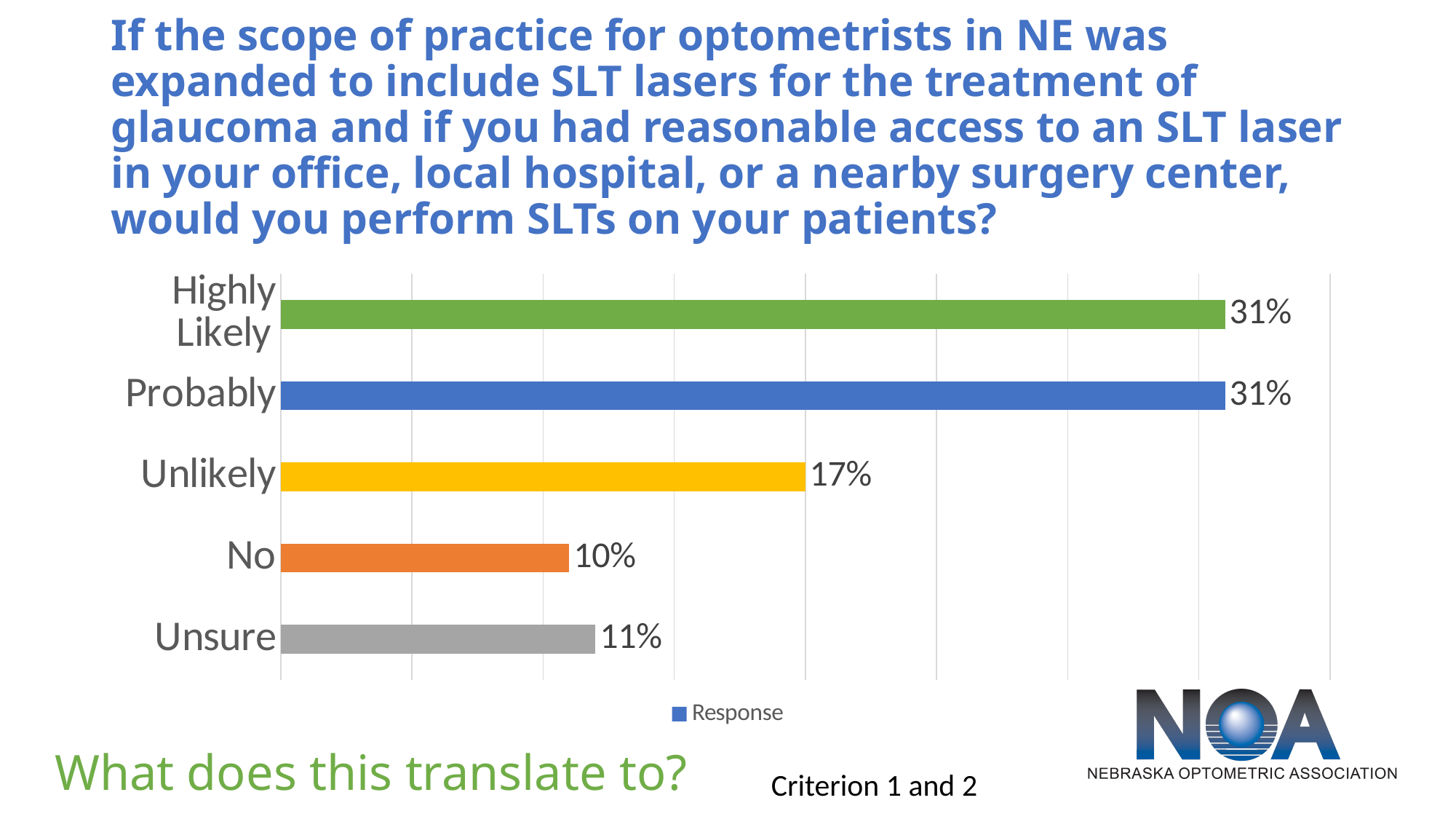
What is the value for Unlikely? 17% How many series does the legend list? 1 What is the value for No? 10% What kind of chart is shown on the slide? Bar chart Which category has the lowest value? No What is the name of the series shown in the legend? Response What is the difference between the values for Probably and Unsure? 20% How many categories are shown in the chart? 5 What is the value for Unsure? 11% Which is larger, the value for Unlikely or the value for Unsure? Unlikely What is the difference between the values for Unlikely and No? 7% What is the value for Highly Likely? 31%